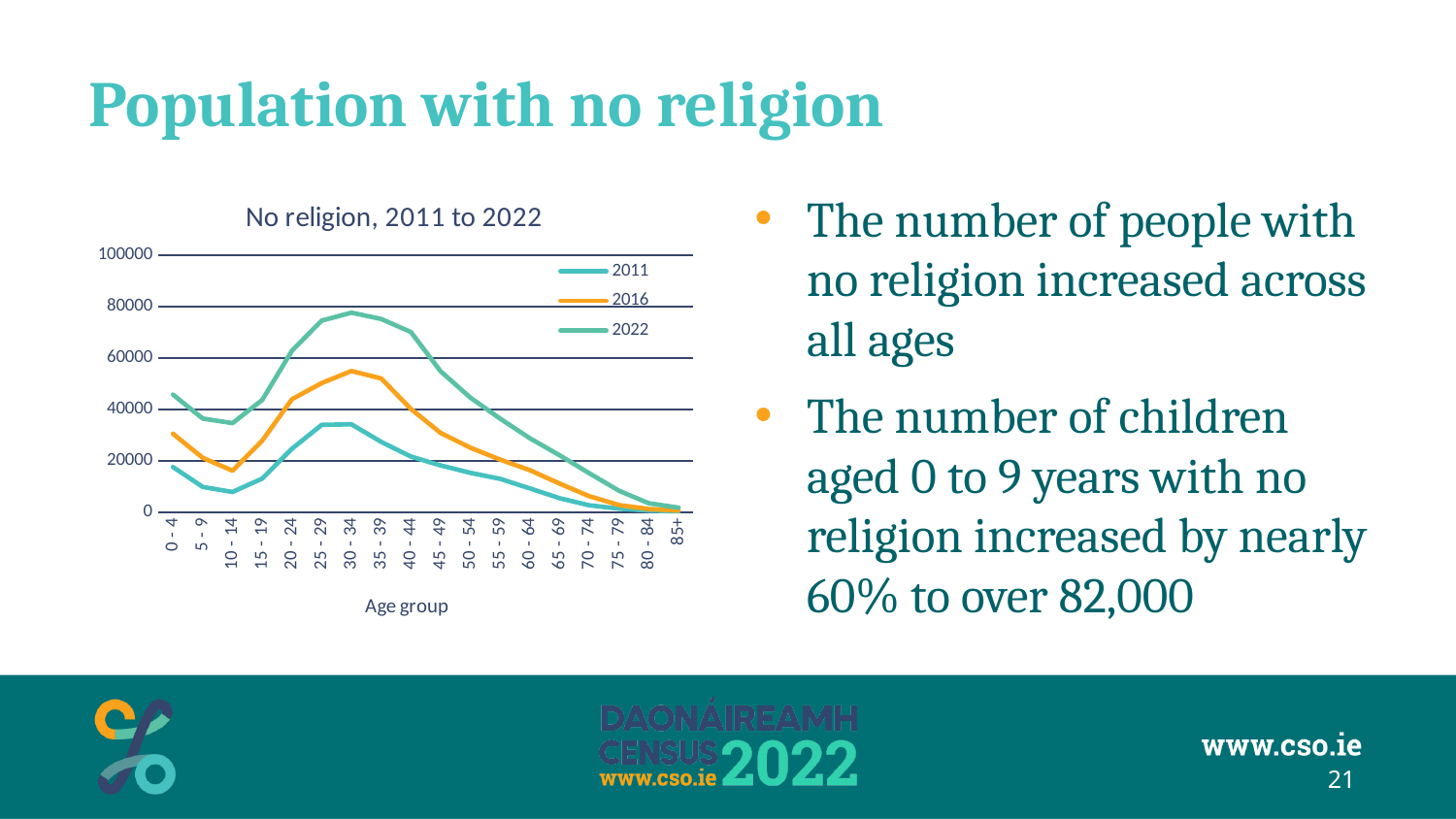
What is the title of the chart? No religion, 2011 to 2022 Which age group has the highest value for the 2016 series? 30 - 34 Which age group has the highest value for the 2022 series? 30 - 34 Do the 2022 values rise or fall from the 30 - 34 age group to the 85+ age group? fall Which age group has the lowest value for the 2022 series? 85+ What kind of chart is shown on the slide? line chart How many series does the legend of the chart list? 3 Is the 2016 value for the 0 - 4 age group greater or less than 20000? greater Is the 2022 value for the 30 - 34 age group greater or less than 60000? greater Is the 2011 value for the 10 - 14 age group greater or less than 20000? less How many age groups are shown on the x axis of the chart? 18 For the 30 - 34 age group, which series has the larger value, 2011 or 2022? 2022